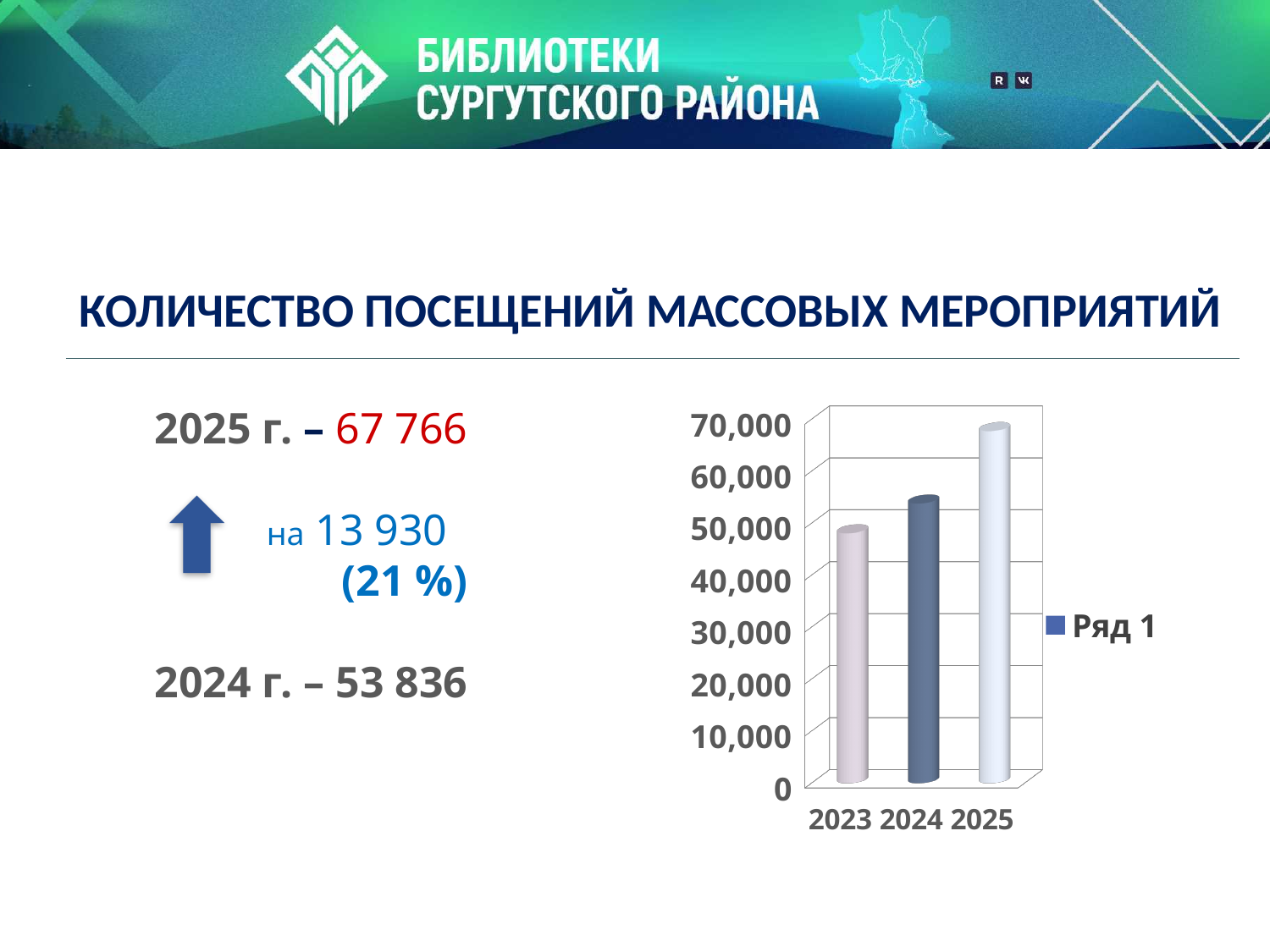
How many years (categories) are plotted on the chart? 3 According to the slide, what is the number of visits to mass events in 2024? 53 836 Which year has the highest bar on the chart? 2025 What is the name of the series shown in the chart legend? Ряд 1 Which is larger, the value for 2024 or the value for 2023? 2024 Is the value for 2025 greater or less than 60,000? greater Which year has the lowest bar on the chart? 2023 Do the values rise or fall from 2023 to 2025 along the x axis? rise Is the value for 2023 greater or less than 40,000? greater What kind of chart is shown on the slide? bar chart According to the slide, what is the number of visits to mass events in 2025? 67 766 How many series does the chart legend list? 1